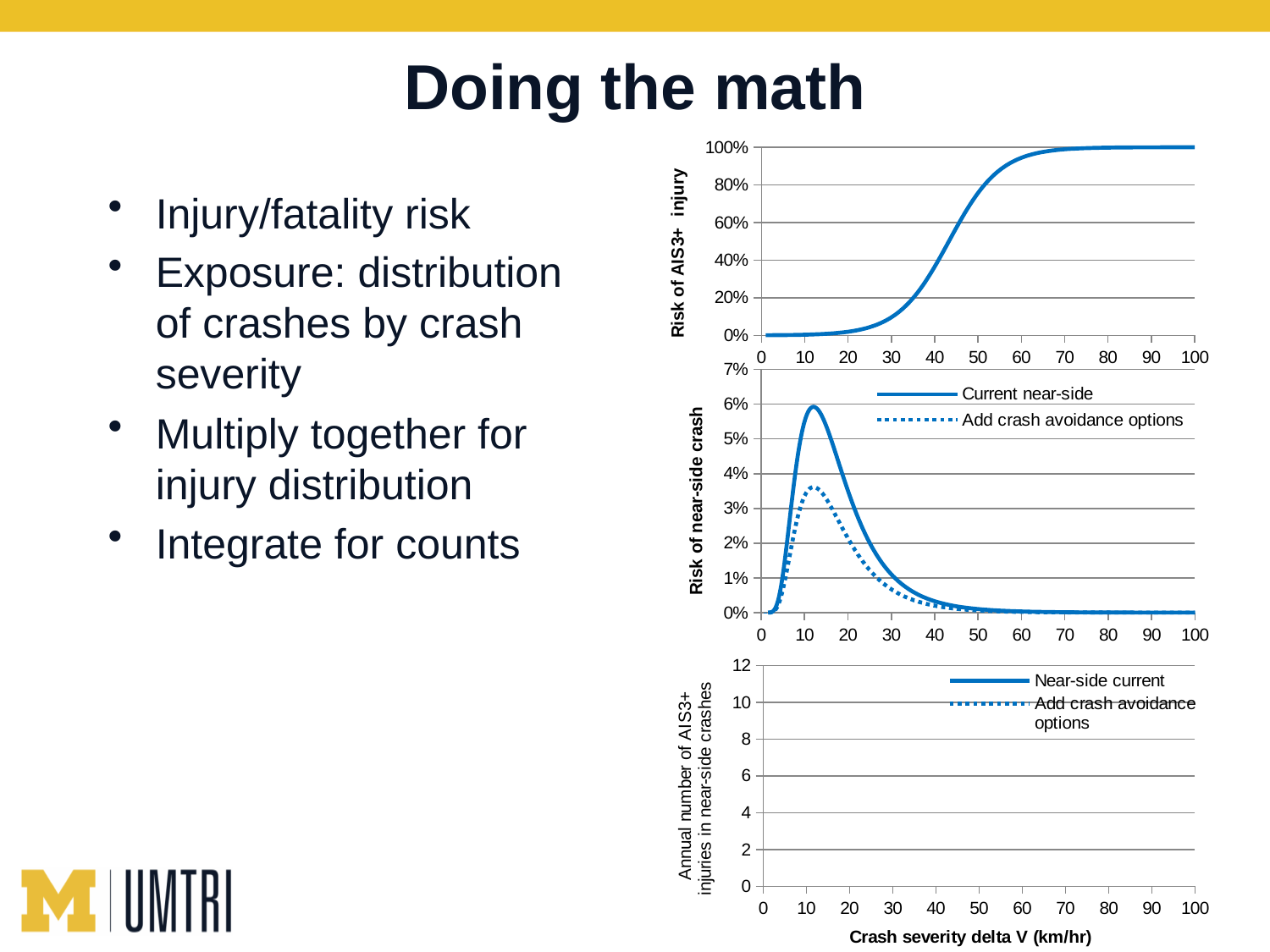
In the top chart (Risk of AIS3+ injury), does the risk rise or fall as crash severity increases along the x axis? Rises What kind of chart is the top chart (Risk of AIS3+ injury)? Line chart In the middle chart (Risk of near-side crash), is the Current near-side value at a crash severity of 20 greater or less than 3%? greater In the middle chart (Risk of near-side crash), is the peak value of the Add crash avoidance options series greater or less than 4%? less How many series does the legend of the bottom chart (Annual number of AIS3+ injuries in near-side crashes) list? 2 In the top chart (Risk of AIS3+ injury), is the value at a crash severity of 30 greater or less than 20%? less What is the x-axis label shown under the bottom chart? Crash severity delta V (km/hr) How many series does the legend of the middle chart (Risk of near-side crash) list? 2 In the middle chart (Risk of near-side crash), which series is higher at a crash severity of 10: Current near-side or Add crash avoidance options? Current near-side What are the two legend entries in the middle chart (Risk of near-side crash)? Current near-side; Add crash avoidance options